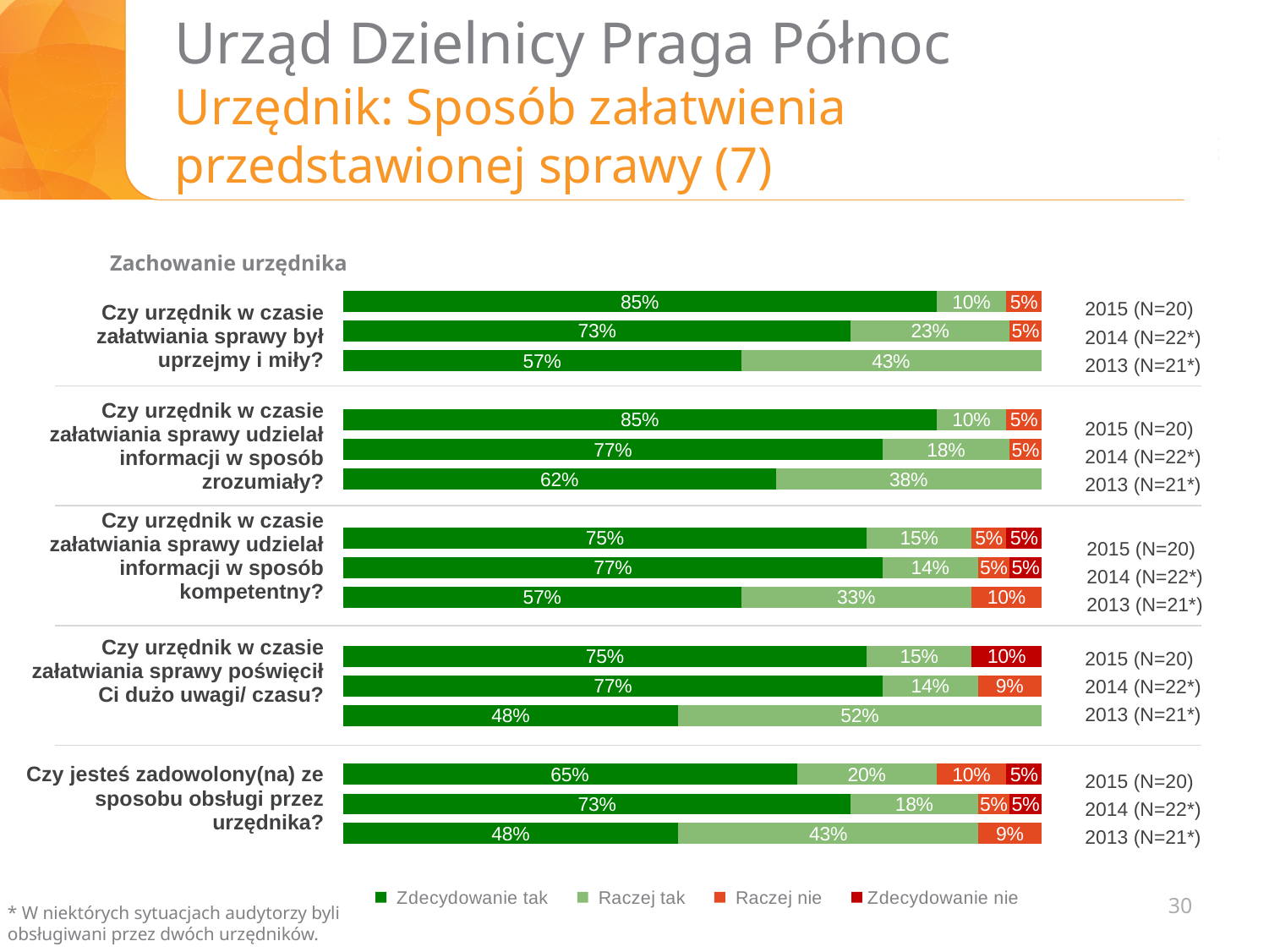
In the chart for "Czy jesteś zadowolony(na) ze sposobu obsługi przez urzędnika?", which year has the lowest share of "Zdecydowanie tak"? 2013 (N=21*) In the chart for "Czy urzędnik w czasie załatwiania sprawy był uprzejmy i miły?", what percentage answered "Raczej tak" in 2014 (N=22*)? 23% In the chart for "Czy urzędnik w czasie załatwiania sprawy był uprzejmy i miły?", by how many percentage points does the "Zdecydowanie tak" share in 2015 exceed that in 2013? 28 percentage points In the chart for "Czy urzędnik w czasie załatwiania sprawy był uprzejmy i miły?", does the "Zdecydowanie tak" share rise or fall from 2013 to 2015? Rises In the chart for "Czy urzędnik w czasie załatwiania sprawy udzielał informacji w sposób zrozumiały?", which year has the highest share of "Zdecydowanie tak"? 2015 (N=20) What type of chart is used on this slide? Stacked bar chart How many response categories does the legend list? 4 In the chart for "Czy urzędnik w czasie załatwiania sprawy był uprzejmy i miły?", what percentage answered "Zdecydowanie tak" in 2015 (N=20)? 85% How many bars (years) are shown for each question on the slide? 3 In the chart for "Czy urzędnik w czasie załatwiania sprawy poświęcił Ci dużo uwagi/ czasu?", what percentage answered "Raczej tak" in 2013 (N=21*)? 52% In the chart for "Czy urzędnik w czasie załatwiania sprawy udzielał informacji w sposób kompetentny?", which year has the larger "Zdecydowanie tak" share, 2015 or 2014? 2014 (N=22*) In the chart for "Czy jesteś zadowolony(na) ze sposobu obsługi przez urzędnika?", what percentage answered "Zdecydowanie tak" in 2013 (N=21*)? 48%